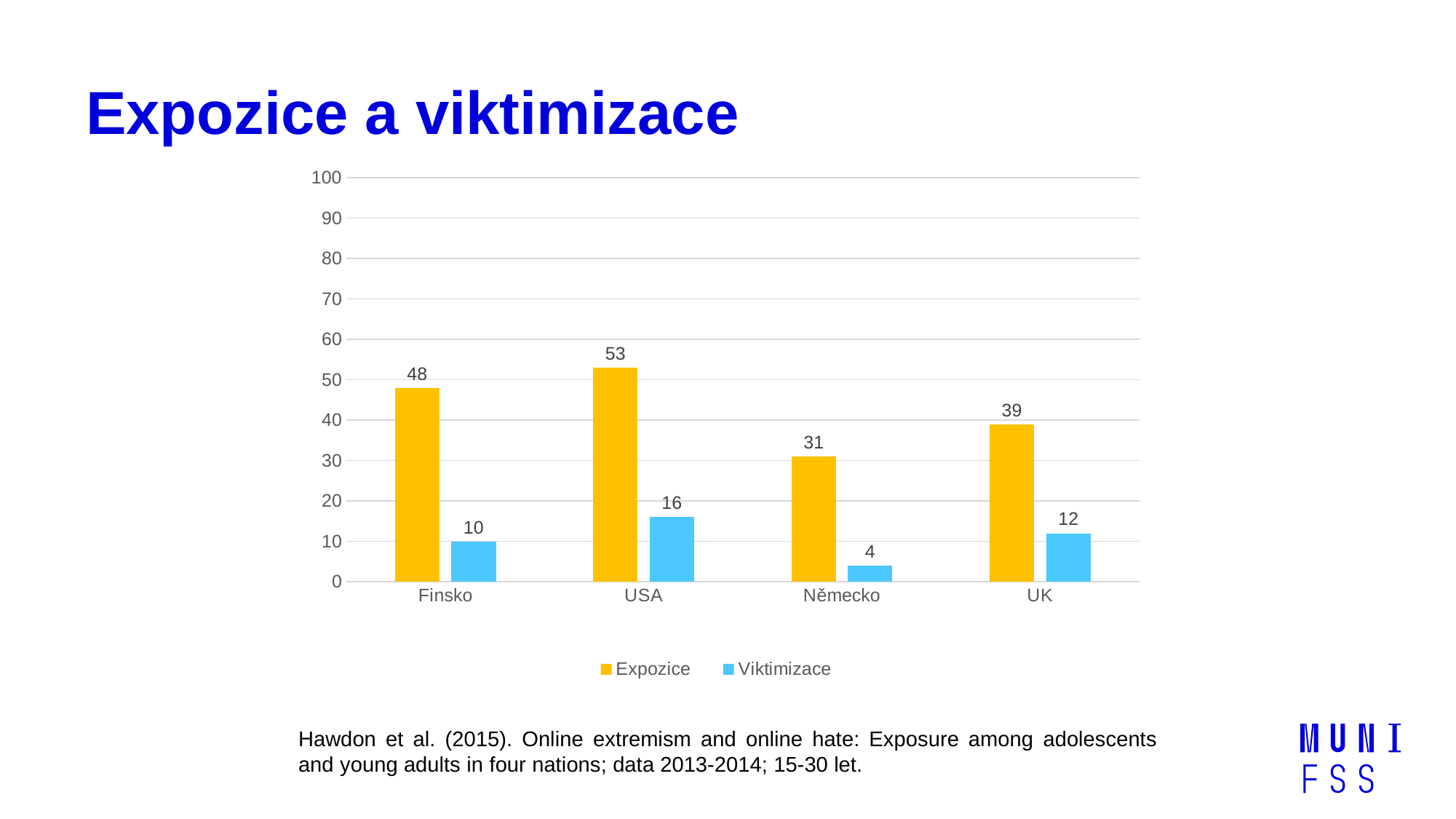
Is the Expozice value for Německo greater or less than 40? less What colour are the Viktimizace bars? light blue What is the Viktimizace value for Německo? 4 What is the Expozice value for Finsko? 48 What is the Viktimizace value for USA? 16 Which country has the lowest Viktimizace value? Německo Which country has the highest Expozice value? USA How many countries are shown on the x axis? 4 What is the difference between the Expozice and Viktimizace values for UK? 27 How many series does the legend list? 2 Which is larger, the Expozice value for Finsko or the Expozice value for UK? Finsko What kind of chart is shown on the slide? bar chart